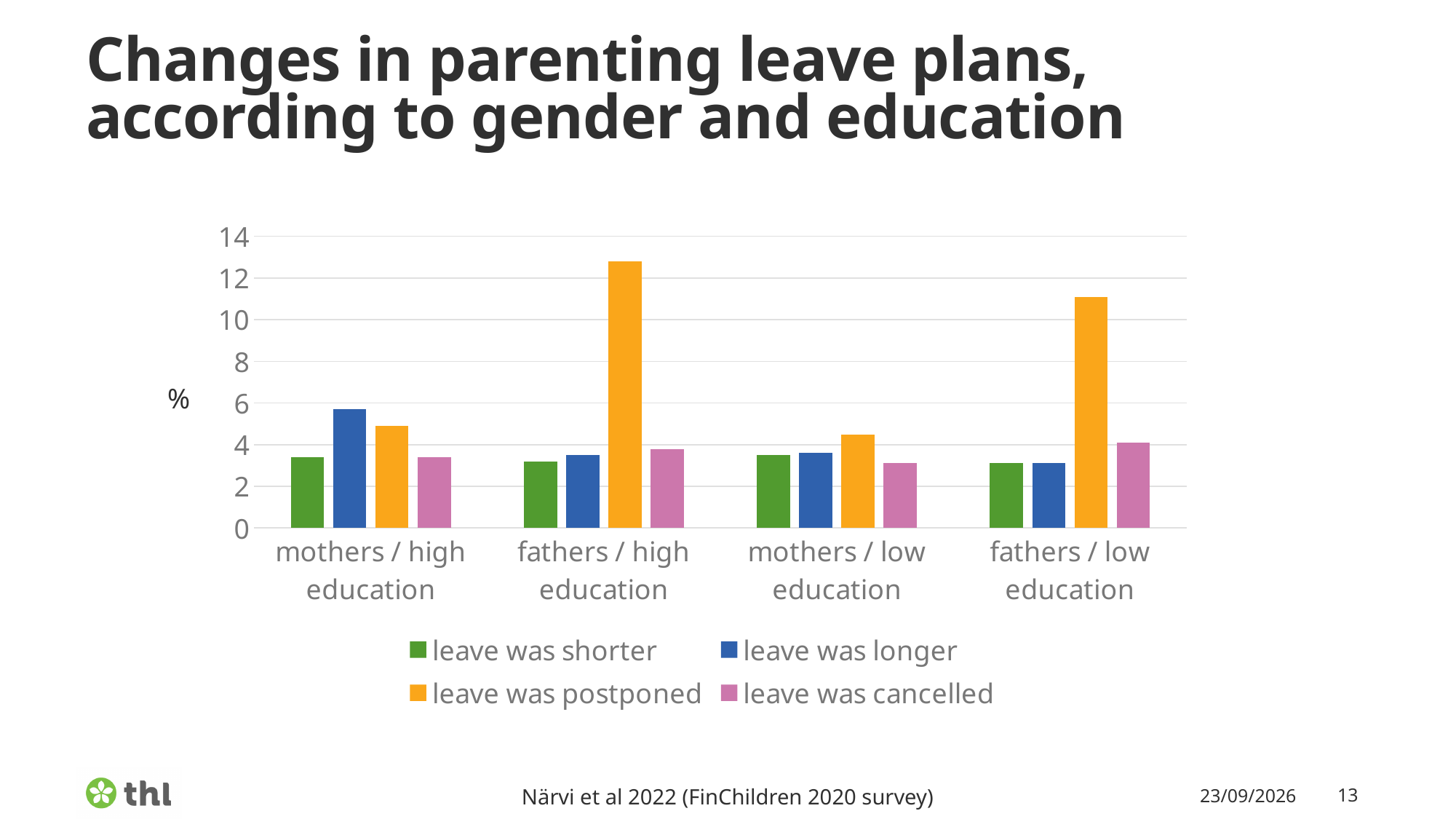
Is the value for 'leave was longer' for mothers / high education greater or less than 4? greater How many series does the legend list? 4 Is the value for 'leave was postponed' for fathers / high education greater or less than 10? greater Which category has the highest value for 'leave was postponed'? fathers / high education Which category has the lowest value for 'leave was postponed'? mothers / low education Is the value for 'leave was cancelled' for mothers / low education greater or less than 4? less What colour represents 'leave was postponed' in the chart? orange Which is larger: 'leave was postponed' for fathers / high education or for fathers / low education? fathers / high education Which is larger for mothers / high education: 'leave was longer' or 'leave was shorter'? leave was longer What kind of chart is shown on the slide? bar chart How many categories are shown on the x axis? 4